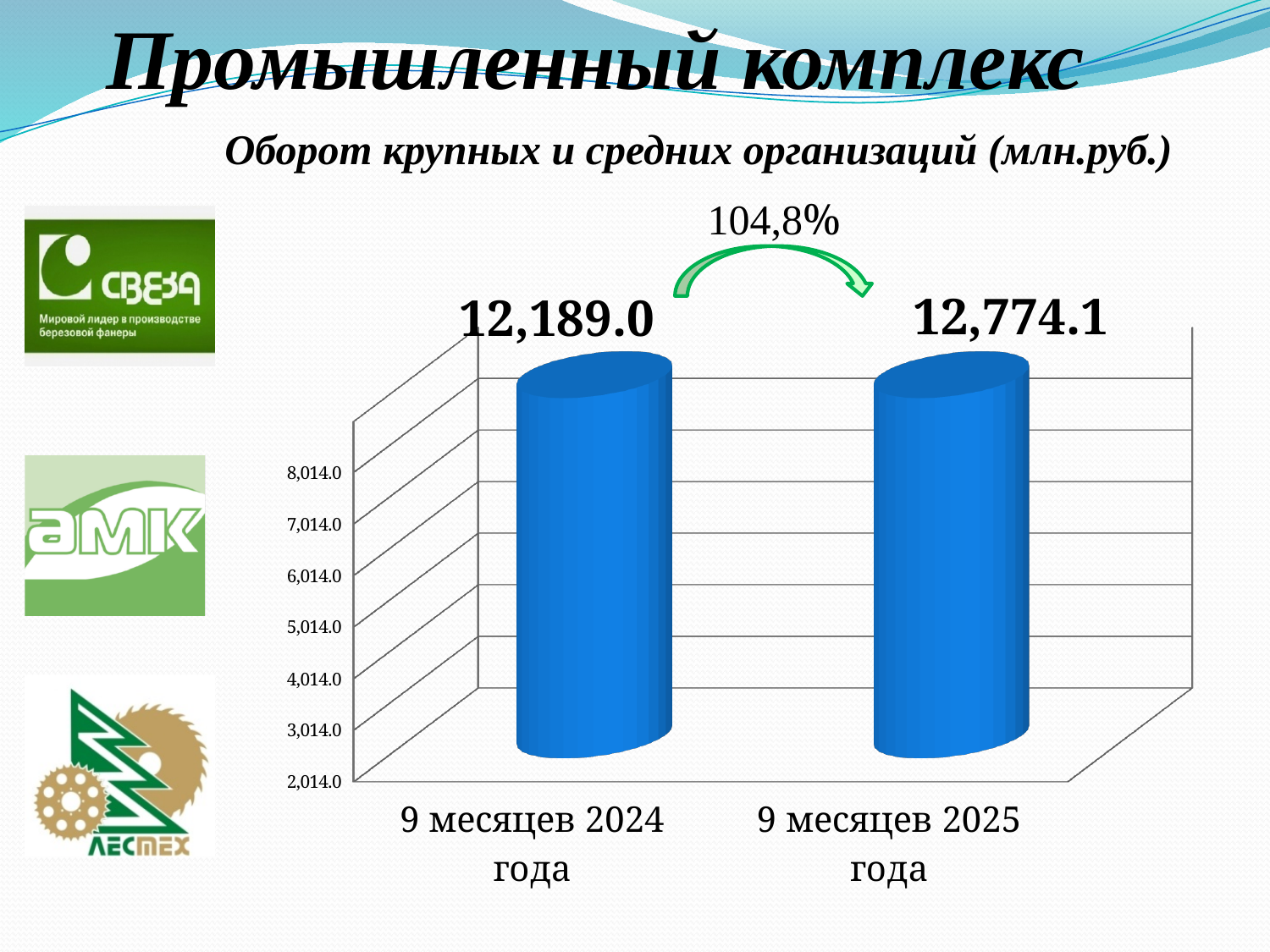
What percentage is shown above the arrow between the two bars? 104,8% Do the values rise or fall from 9 месяцев 2024 года to 9 месяцев 2025 года? rise What is the value for 9 месяцев 2024 года? 12,189.0 Which category has the lowest value? 9 месяцев 2024 года Which category has the highest value? 9 месяцев 2025 года Is the value for 9 месяцев 2024 года greater or less than 8,014.0? greater What is the difference between the values for 9 месяцев 2025 года and 9 месяцев 2024 года? 585.1 How many categories are shown on the chart? 2 What kind of chart is shown on the slide? bar chart What is the value for 9 месяцев 2025 года? 12,774.1 What is the title of the chart? Оборот крупных и средних организаций (млн.руб.) Which is larger: the value for 9 месяцев 2024 года or for 9 месяцев 2025 года? 9 месяцев 2025 года